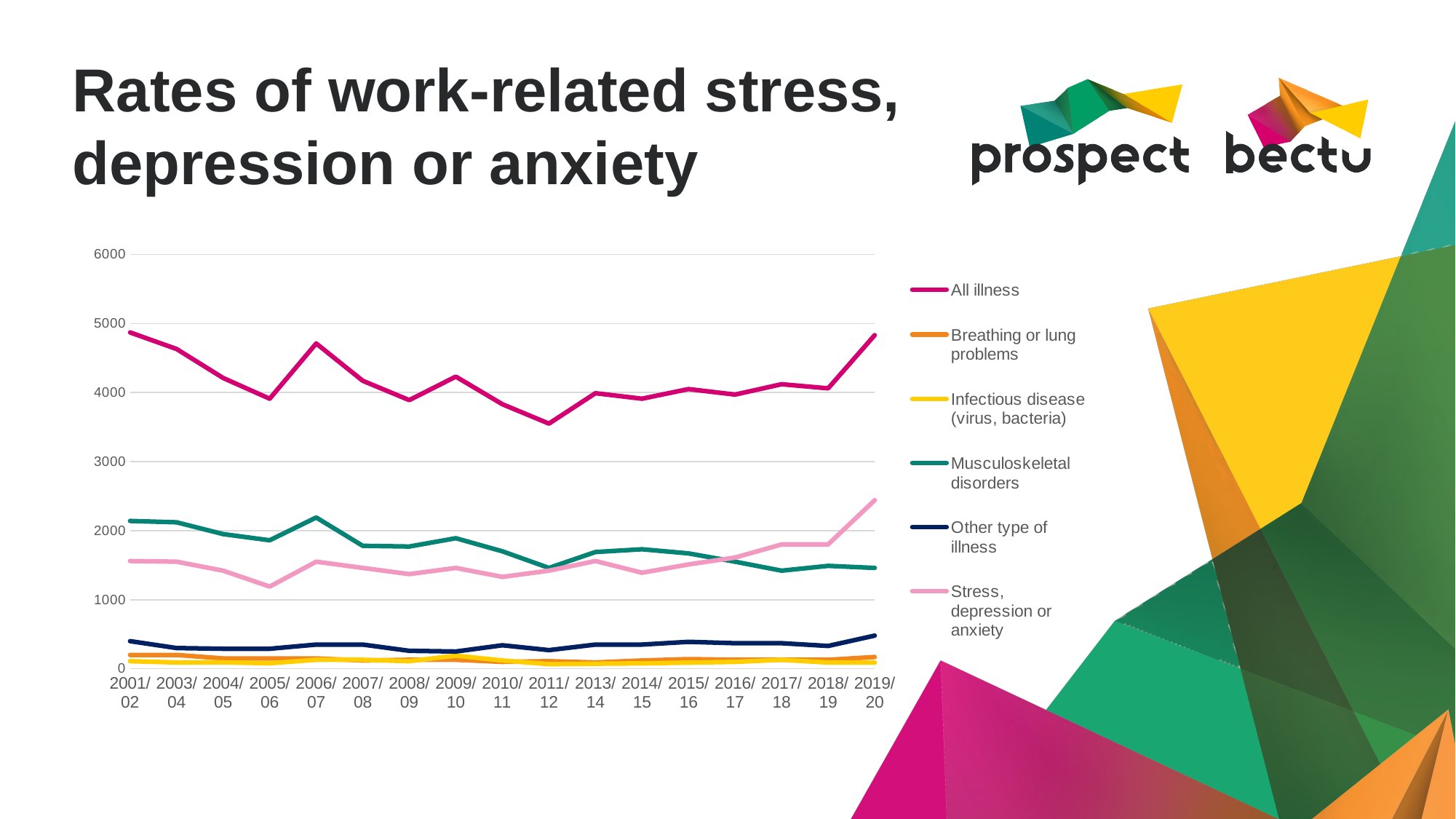
What kind of chart is shown on the slide? line chart In 2019/20, which is larger: Musculoskeletal disorders or Stress, depression or anxiety? Stress, depression or anxiety Which series has the lowest values across the whole chart? Infectious disease (virus, bacteria) In 2001/02, which is larger: Musculoskeletal disorders or Stress, depression or anxiety? Musculoskeletal disorders Is the All illness value for 2011/12 greater or less than 4000? less How many time periods are shown on the x axis? 17 Is the All illness value for 2001/02 greater or less than 4000? greater In which period is the Stress, depression or anxiety value highest? 2019/20 In which period is the All illness value lowest? 2011/12 Which series has the highest values across the whole chart? All illness How many series does the legend list? 6 Is the Stress, depression or anxiety value for 2019/20 greater or less than 2000? greater